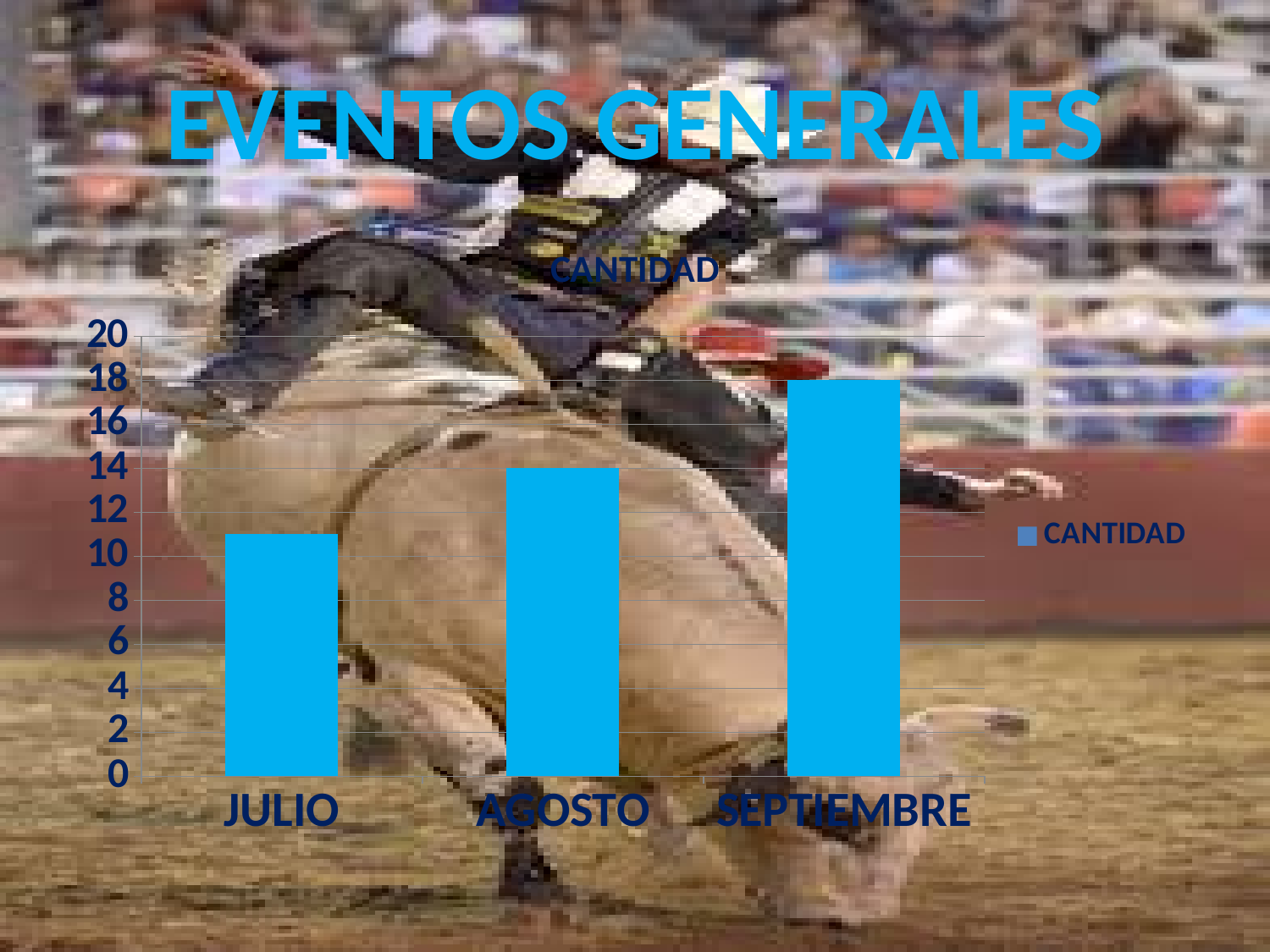
Is the value for JULIO greater or less than 12? less Which month has the highest value in the chart? SEPTIEMBRE How many categories are shown on the x axis of the chart? 3 What kind of chart is shown on the slide? bar chart Which is larger, the value for AGOSTO or the value for SEPTIEMBRE? SEPTIEMBRE Is the value for JULIO greater or less than 10? greater What is the value for SEPTIEMBRE? 18 What is the title of the chart? CANTIDAD Do the values rise or fall from JULIO to SEPTIEMBRE? rise How many series does the chart legend list? 1 What is the value for AGOSTO? 14 Which month has the lowest value in the chart? JULIO